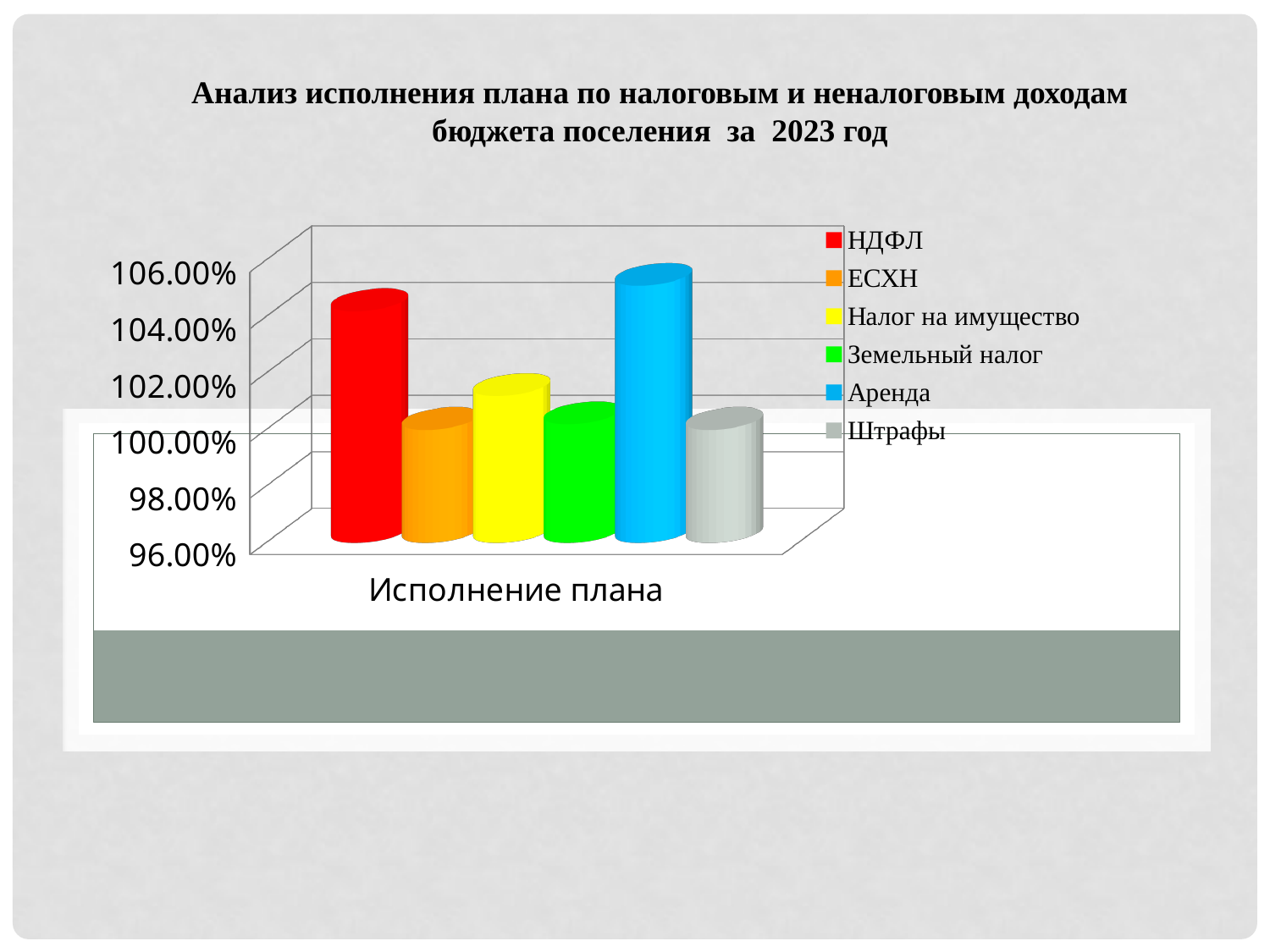
Which series has the highest value? Аренда Which is larger, the value for Аренда or the value for Земельный налог? Аренда Is the value for ЕСХН greater or less than 102.00%? less Is the value for Штрафы greater or less than 102.00%? less Is the value for Аренда greater or less than 104.00%? greater What is the label shown on the x axis of the chart? Исполнение плана Which is larger, the value for НДФЛ or the value for ЕСХН? НДФЛ What kind of chart is shown on the slide? Bar chart How many series does the legend list? 6 How many categories are shown on the x axis? 1